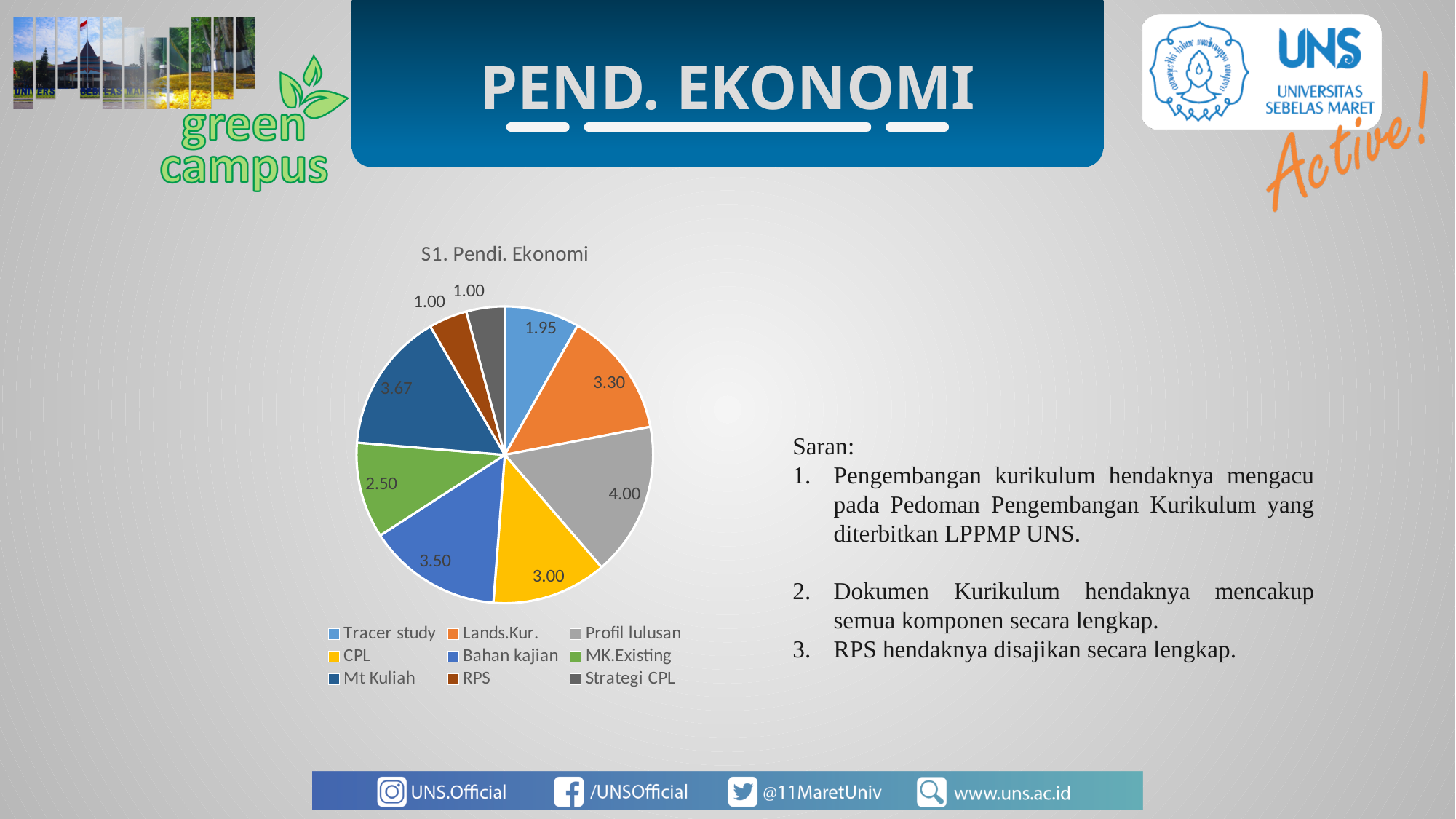
What is the difference between the values for Bahan kajian and CPL? 0.50 How many categories does the pie chart have? 9 What is the value for MK.Existing? 2.50 What type of chart is shown on the slide? Pie chart Which category has the highest value? Profil lulusan What is the value for Tracer study? 1.95 Which colour represents RPS in the legend? Brown What is the value for Mt Kuliah? 3.67 What is the difference between the values for Profil lulusan and Tracer study? 2.05 What is the value for Profil lulusan? 4.00 What is the title of the chart? S1. Pendi. Ekonomi Which is larger, the value for Lands.Kur. or the value for MK.Existing? Lands.Kur.